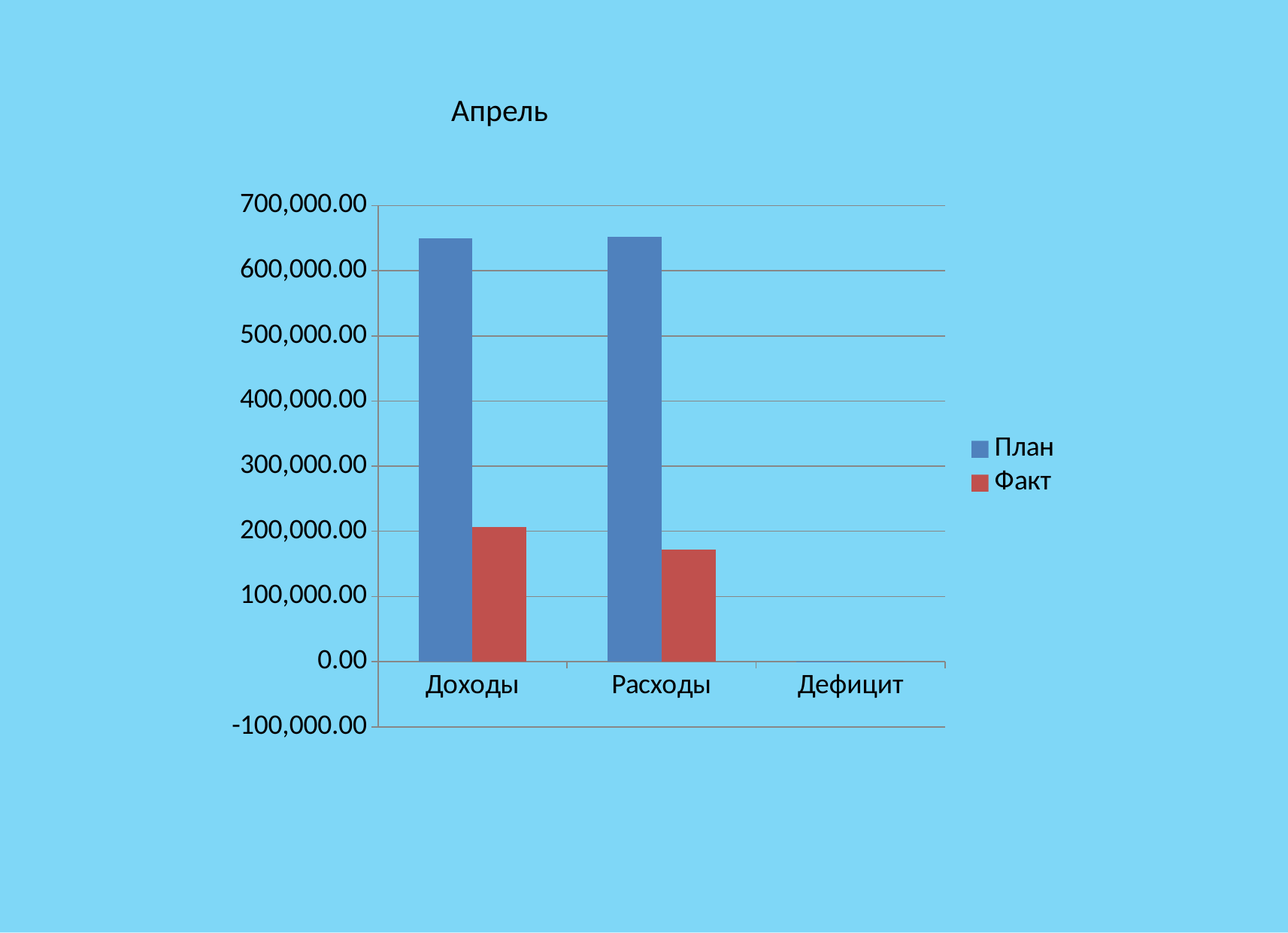
Is the План value for Доходы greater or less than 600,000.00? greater Which category has the highest Факт value? Доходы Which category has the lowest План value? Дефицит What kind of chart is shown on the slide? bar chart How many categories are shown on the x axis? 3 How many series does the legend list? 2 Which series are listed in the legend? План, Факт What is the title of the chart? Апрель Is the Факт value for Расходы greater or less than 200,000.00? less Is the Факт value for Доходы greater or less than 300,000.00? less For Доходы, which is larger: the План value or the Факт value? План